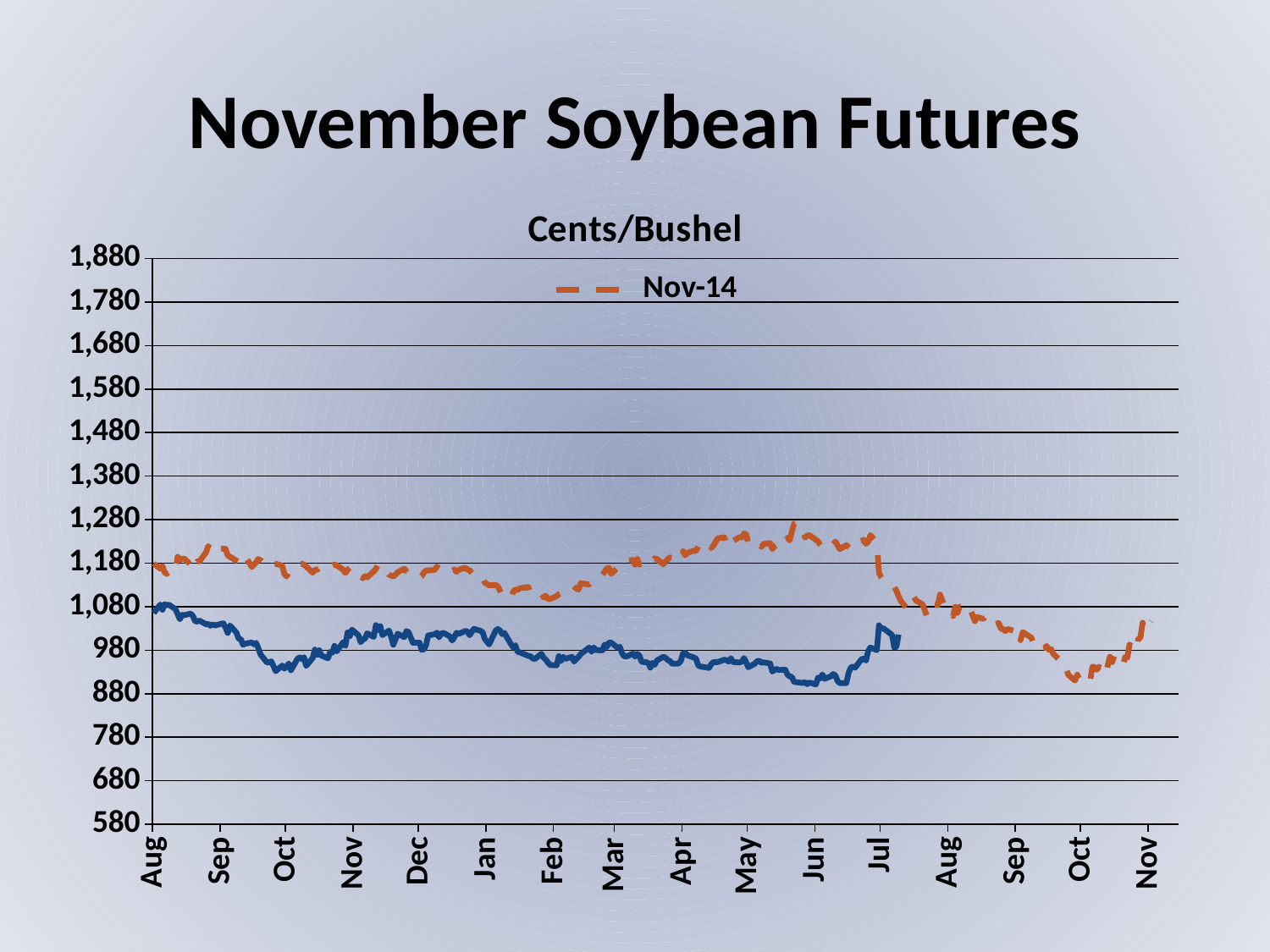
How many series does the chart's legend list? 1 Is the Nov-14 value in Feb greater or less than 1,180? less What series name appears in the chart's legend? Nov-14 Around which month does the Nov-14 line reach its lowest point? Oct (the second Oct) Is the Nov-14 value at the second Oct label greater or less than 980? less How many month labels are shown along the x axis? 16 Is the Nov-14 value in May greater or less than 1,180? greater What kind of chart is shown on the slide? line chart What is the title shown above the chart's plot area? Cents/Bushel Does the Nov-14 line rise or fall between Jun and the second Oct? fall Does the Nov-14 line rise or fall between Feb and May? rise Around which month does the Nov-14 line reach its highest point? May